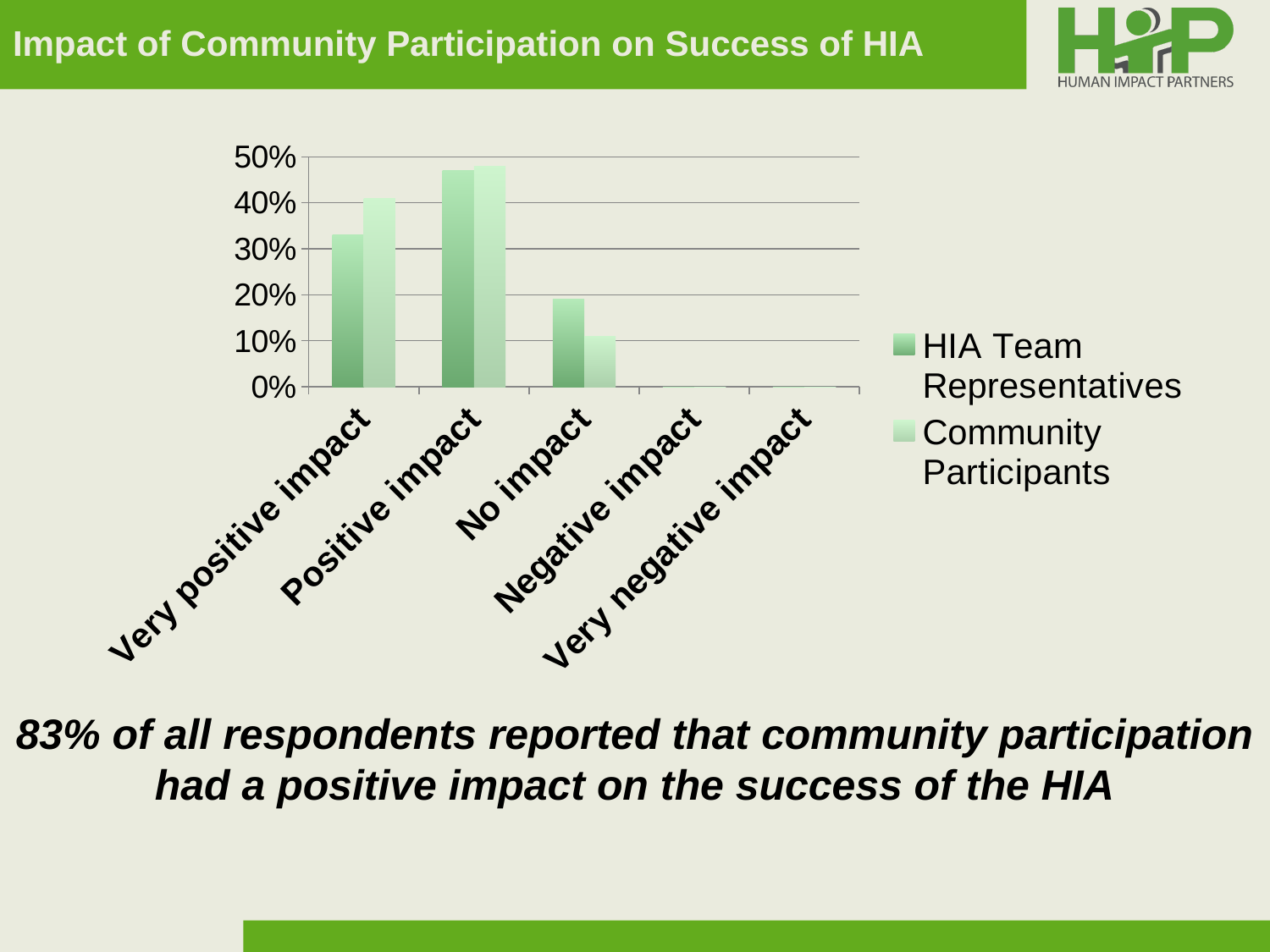
Is the value for Community Participants at No impact greater or less than 20%? less What are the two series named in the chart's legend? HIA Team Representatives and Community Participants For No impact, which series has the larger value: HIA Team Representatives or Community Participants? HIA Team Representatives For the HIA Team Representatives series, which category has the highest value? Positive impact For the Community Participants series, which category has the highest value? Positive impact How many series does the chart's legend list? 2 For Very positive impact, which series has the larger value: HIA Team Representatives or Community Participants? Community Participants How many categories are shown on the x axis of the chart? 5 Is the value for HIA Team Representatives at Positive impact greater or less than 40%? greater Is the value for HIA Team Representatives at Very positive impact greater or less than 20%? greater What is the title of the slide containing the chart? Impact of Community Participation on Success of HIA What kind of chart is shown on the slide? Bar chart